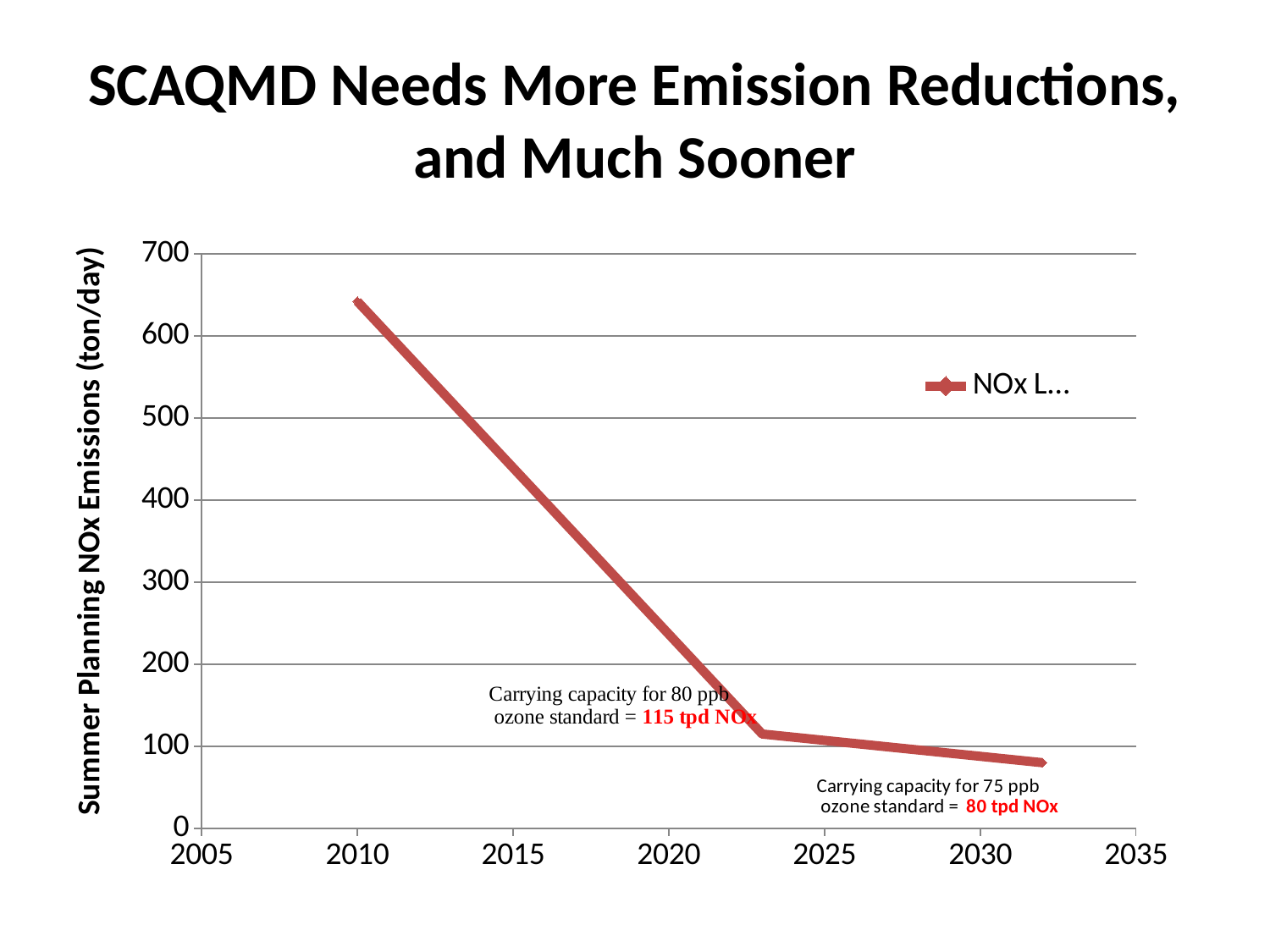
How many series does the legend list? 1 Is the NOx emissions value for 2010 greater or less than 700 ton/day? less Do the NOx emission values rise or fall as the years increase along the x axis? fall What is the difference between the carrying capacity for the 80 ppb standard and the 75 ppb standard? 35 tpd NOx Which is larger, the carrying capacity for the 80 ppb ozone standard or for the 75 ppb ozone standard? 80 ppb ozone standard What is the label on the vertical axis of the chart? Summer Planning NOx Emissions (ton/day) What kind of chart is shown on the slide? line chart Is the NOx emissions value for 2010 greater or less than 600 ton/day? greater According to the annotation, what is the carrying capacity for the 80 ppb ozone standard? 115 tpd NOx Is the final plotted NOx emissions value (around 2032) greater or less than 100 ton/day? less According to the annotation, what is the carrying capacity for the 75 ppb ozone standard? 80 tpd NOx How many data points are plotted on the line? 3